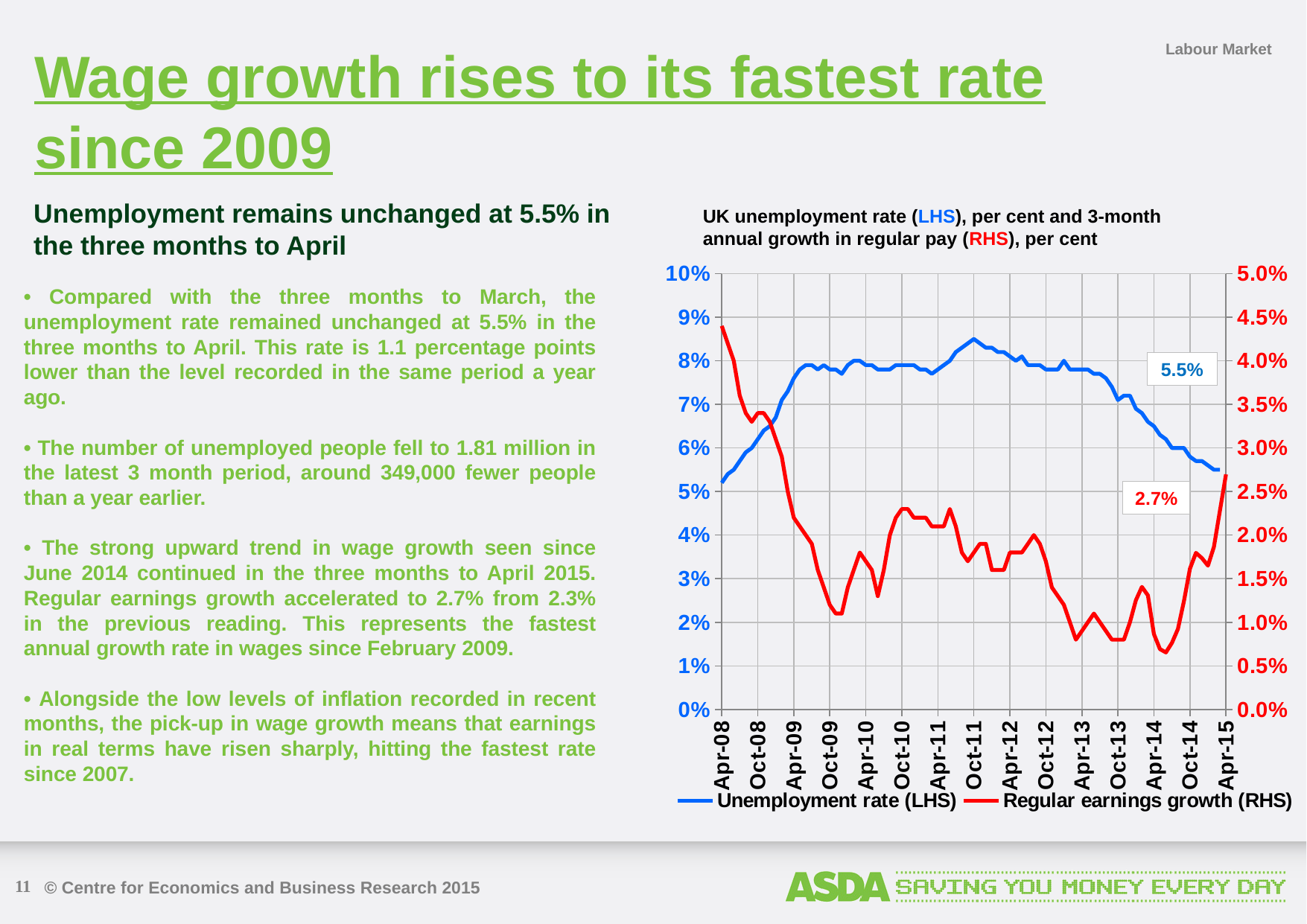
Does the unemployment rate rise or fall between Oct-11 and Apr-15? fall What colour is the line for the unemployment rate (LHS)? blue Is the unemployment rate at Apr-08 greater or less than 6%? less How many date labels are shown on the x axis? 15 What is the labelled value of the unemployment rate at Apr-15? 5.5% What kind of chart is shown on the slide? line chart Which axis is regular earnings growth plotted against, the left-hand or right-hand axis? right-hand axis (RHS) How many series does the chart's legend list? 2 Is regular earnings growth at Apr-14 greater or less than 1.0%? less Is the unemployment rate at Oct-11 greater or less than 8%? greater What is the labelled value of regular earnings growth at Apr-15? 2.7%